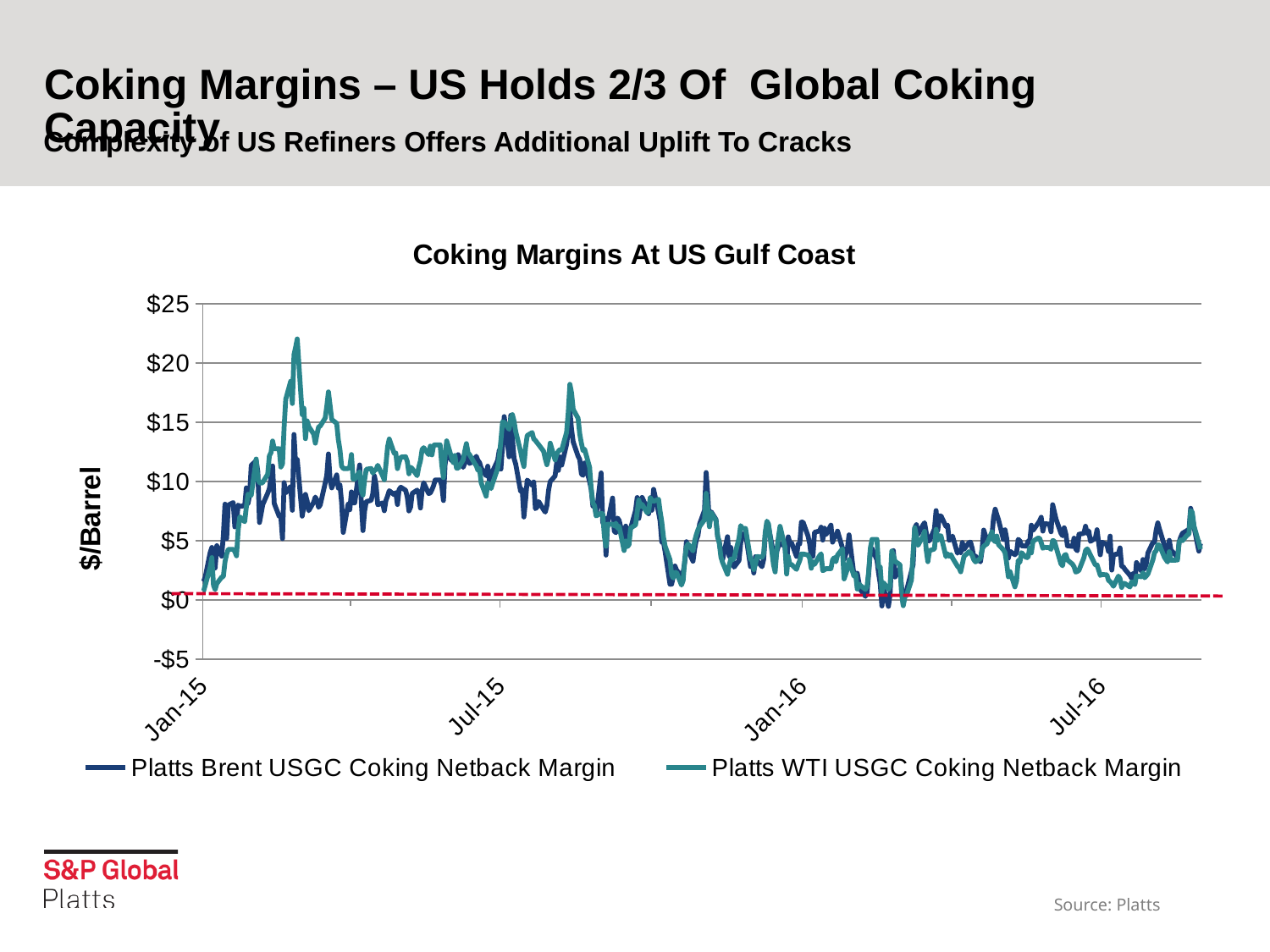
Which series reaches the higher peak value, Platts Brent USGC Coking Netback Margin or Platts WTI USGC Coking Netback Margin? Platts WTI USGC Coking Netback Margin What is the title of the chart? Coking Margins At US Gulf Coast What kind of chart is shown on the slide? line chart Is the value of the Platts WTI USGC Coking Netback Margin series at Jan-15 greater or less than $5? less How many series does the legend list? 2 Is the peak value of the Platts WTI USGC Coking Netback Margin series greater or less than $20? greater How many date labels are shown on the x axis? 4 What is the label on the vertical axis? $/Barrel Is the value of the Platts Brent USGC Coking Netback Margin series at Jul-16 greater or less than $10? less Do the coking margins generally rise or fall from early 2015 to late 2016? fall